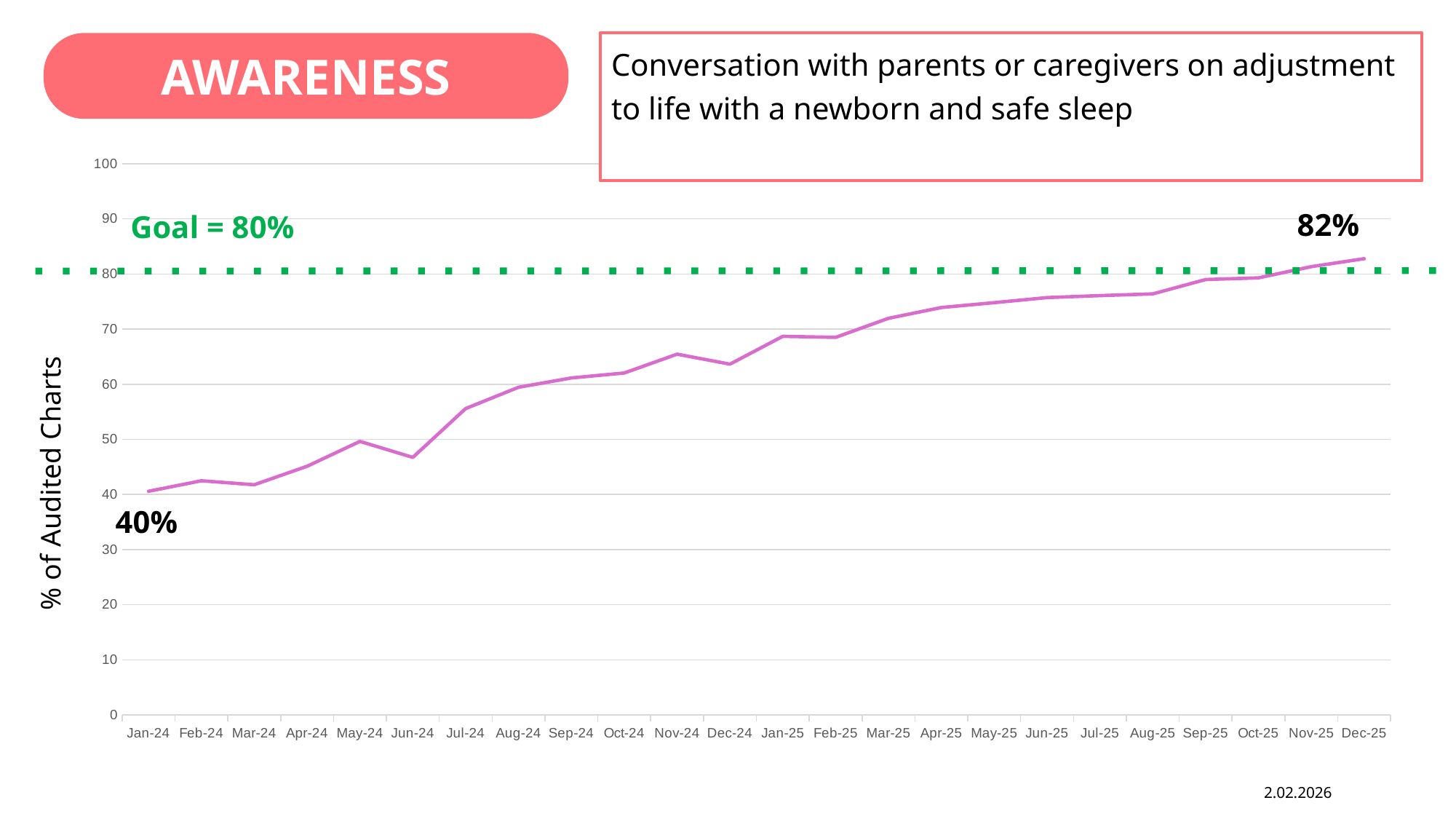
What is the value for Dec-25? 82% What is the value for Jan-24? 40% What is the difference between the Dec-25 value and the Jan-24 value? 42 percentage points Is the value for Mar-25 greater or less than 70? greater How many months are plotted on the x axis? 24 Do the values generally rise or fall from Jan-24 to Dec-25? rise Is the value for Jun-24 greater or less than 50? less What type of chart is shown on the slide? line chart Which month has the lowest value? Jan-24 Which month has the highest value? Dec-25 Which is larger, the value for May-24 or the value for Jun-24? May-24 What goal value is marked by the dotted line on the chart? 80%